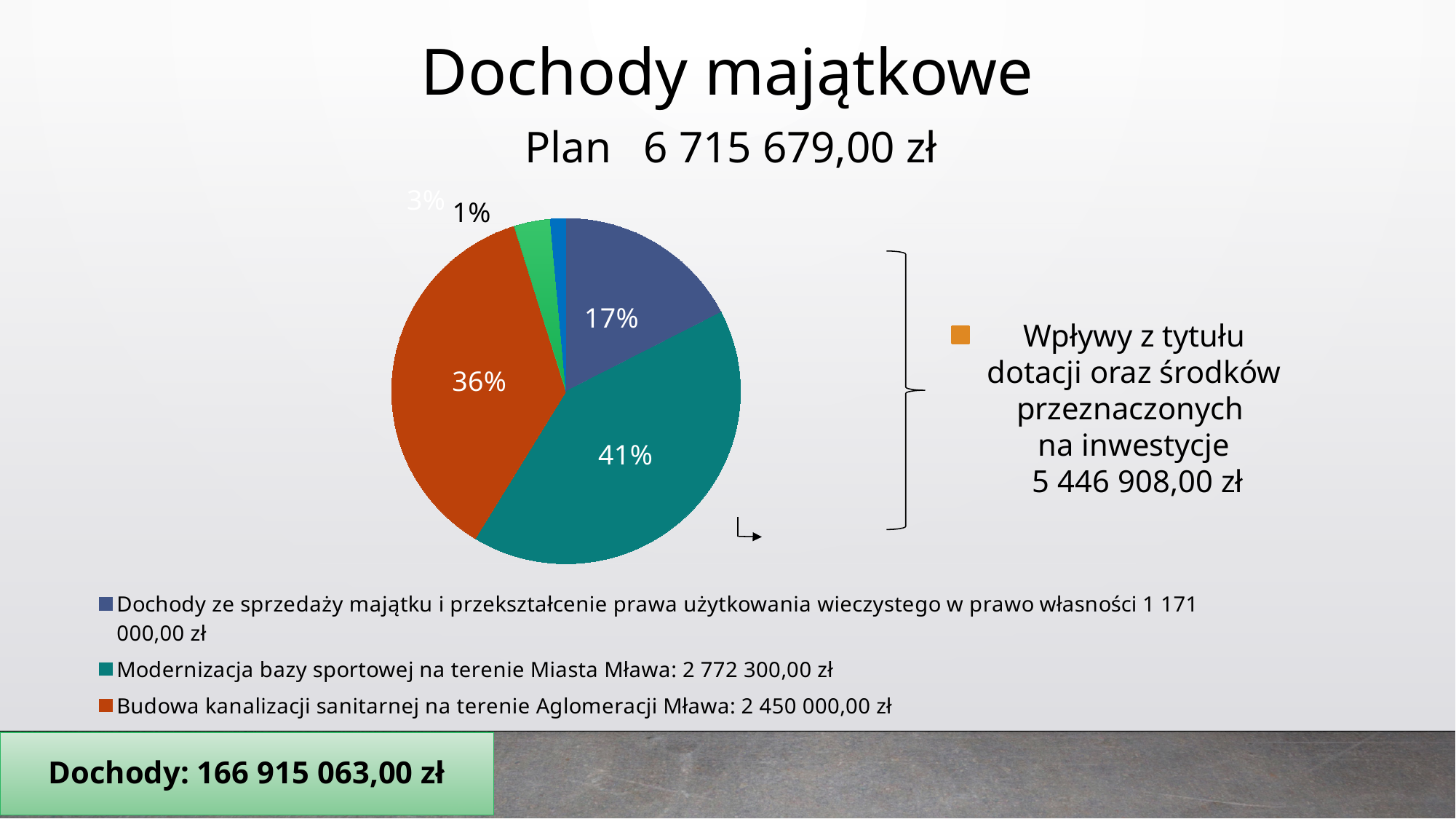
What share of the pie does "Modernizacja bazy sportowej na terenie Miasta Mława" represent? 41% How many slices does the pie chart have? 5 What colour is the slice for "Budowa kanalizacji sanitarnej na terenie Aglomeracji Mława"? orange-red Which slice is larger: "Modernizacja bazy sportowej" or "Budowa kanalizacji sanitarnej"? Modernizacja bazy sportowej What kind of chart is shown on the slide? pie chart What share of the pie does "Dochody ze sprzedaży majątku i przekształcenie prawa użytkowania wieczystego w prawo własności" represent? 17% How many entries does the legend below the pie chart list? 3 What amount does the legend give for "Modernizacja bazy sportowej na terenie Miasta Mława"? 2 772 300,00 zł What is the difference in percentage points between the "Modernizacja bazy sportowej" slice and the "Budowa kanalizacji sanitarnej" slice? 5 percentage points Which category has the largest slice of the pie? Modernizacja bazy sportowej na terenie Miasta Mława What is the smallest percentage labelled on the pie chart? 1% What share of the pie does "Budowa kanalizacji sanitarnej na terenie Aglomeracji Mława" represent? 36%